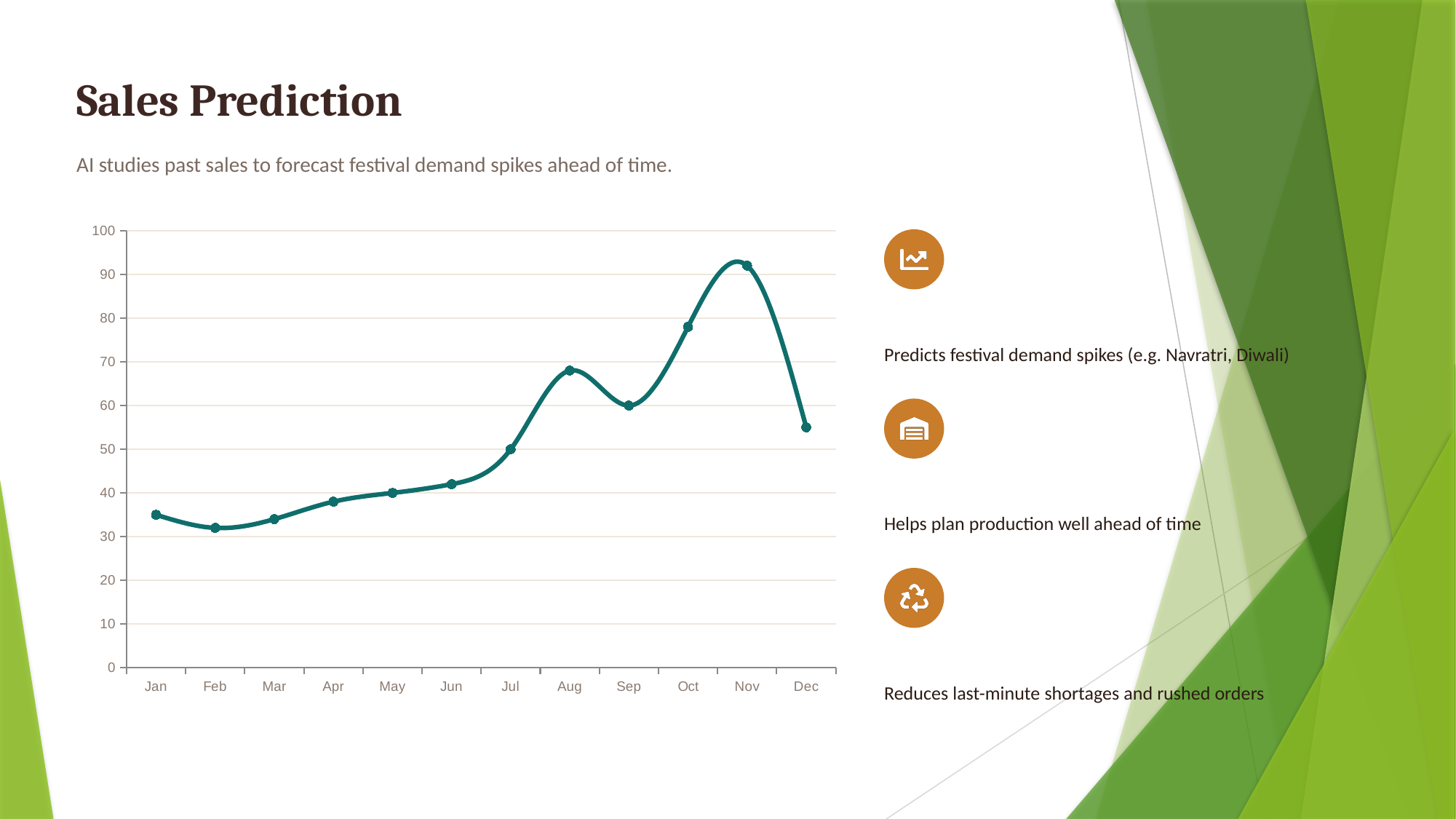
Which month has the lowest value on the chart? Feb What is the value for Sep on the chart? 60 What is the value for May on the chart? 40 How many months are plotted on the x axis of the chart? 12 Which month has the highest value on the chart? Nov What is the value for Jul on the chart? 50 Which month has the larger value, Aug or Oct? Oct What kind of chart is shown on the slide? line chart What is the difference between the values for Sep and Jul? 10 Is the value for Dec greater or less than 60? less Does the line rise or fall from Nov to Dec? fall Is the value for Nov greater or less than 90? greater